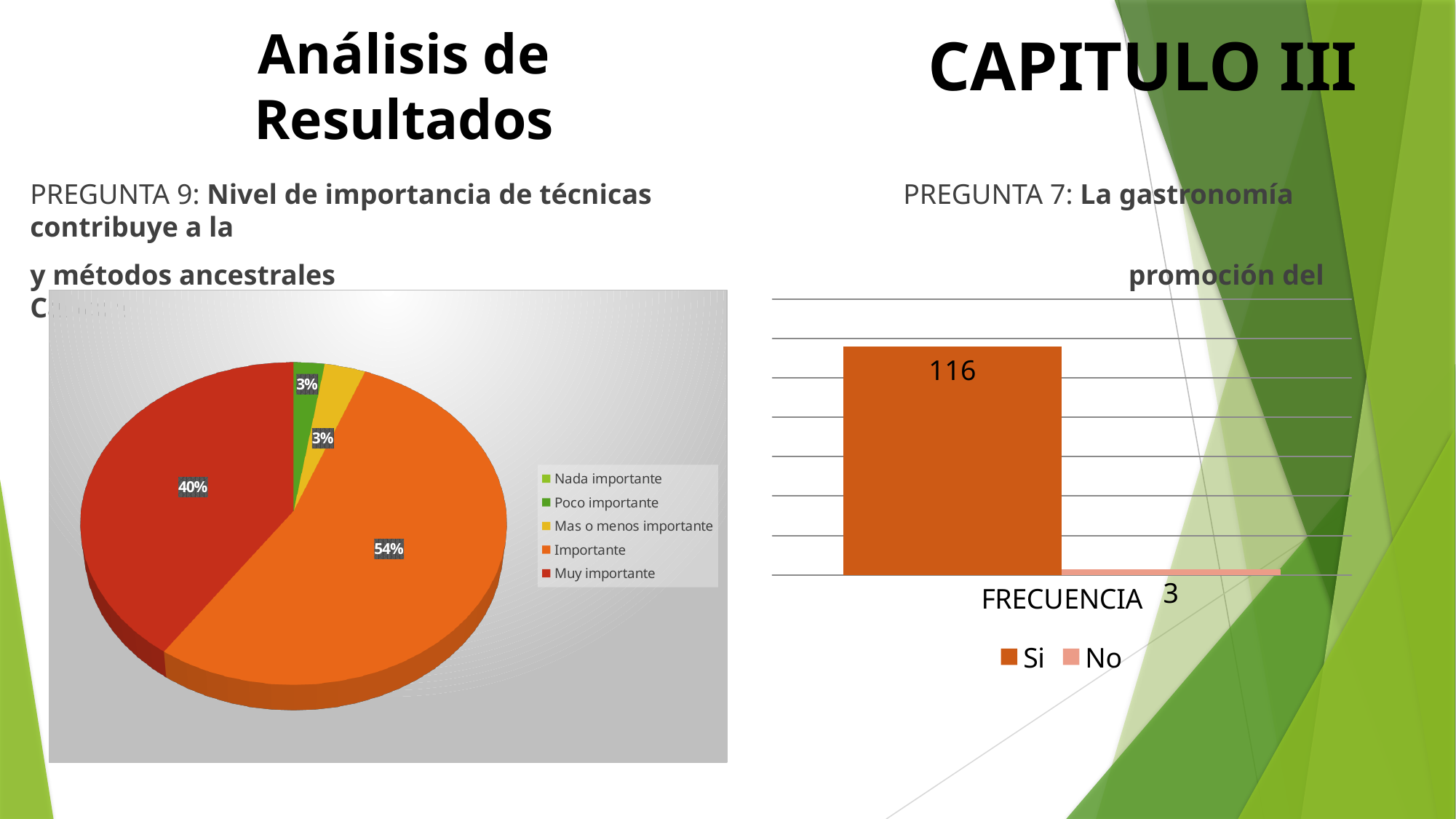
In the bar chart on the right (Pregunta 7), what is the value for No? 3 In the bar chart on the right (Pregunta 7), what is the difference between the Si and No values? 113 In the pie chart on the left (Pregunta 9), how many categories does the legend list? 5 In the bar chart on the right (Pregunta 7), which series has the larger value, Si or No? Si In the pie chart on the left (Pregunta 9), which category has the largest share? Importante In the bar chart on the right (Pregunta 7), what is the value for Si? 116 What kind of chart is shown on the left side of the slide (Pregunta 9)? Pie chart In the bar chart on the right (Pregunta 7), what is the category label on the x axis? FRECUENCIA In the pie chart on the left (Pregunta 9), what share does Muy importante have? 40% What kind of chart is shown on the right side of the slide (Pregunta 7)? Bar chart In the bar chart on the right (Pregunta 7), how many series does the legend list? 2 In the pie chart on the left (Pregunta 9), what share does Importante have? 54%